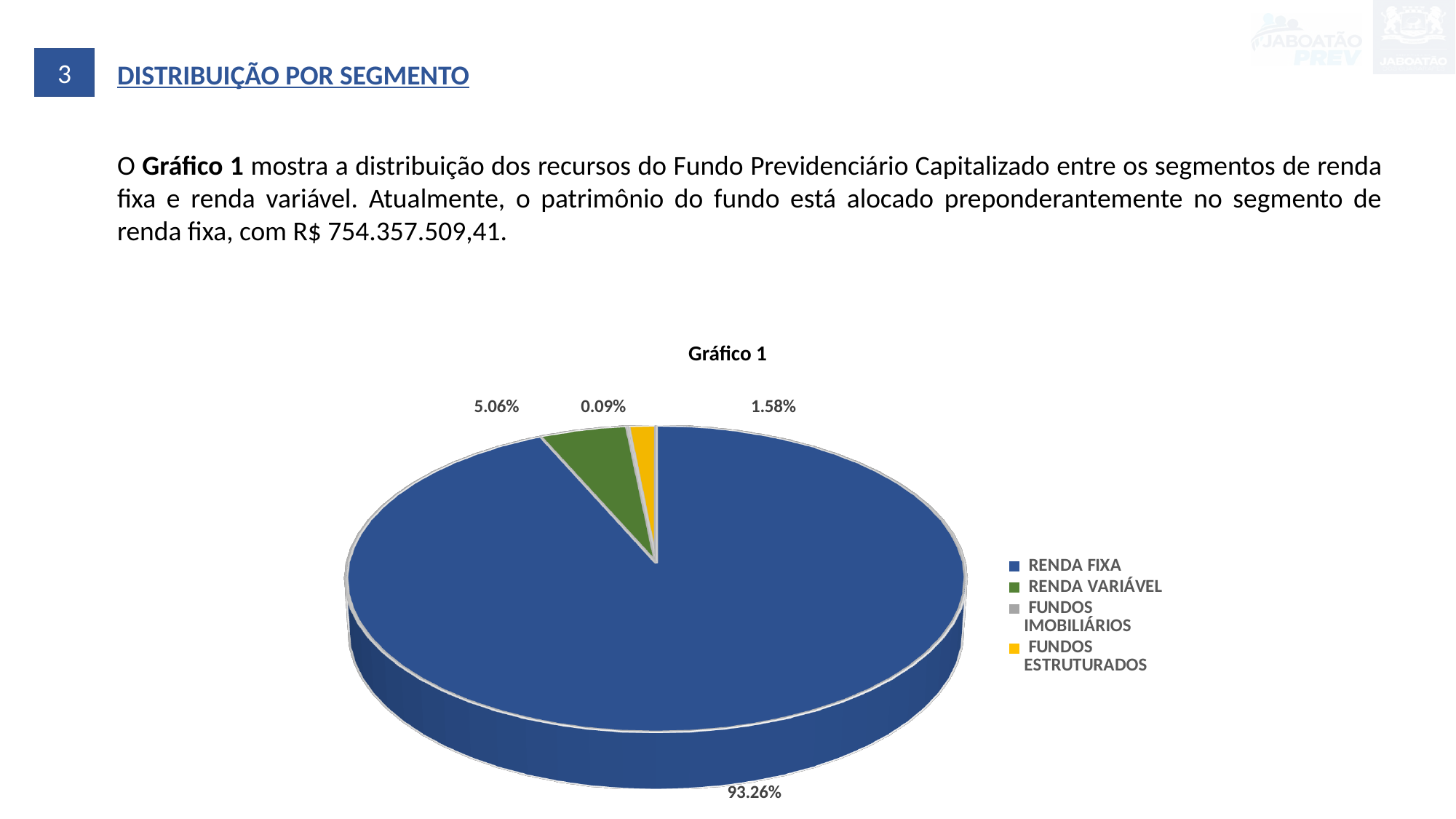
What colour represents FUNDOS ESTRUTURADOS in Gráfico 1? yellow What is the difference in percentage points between RENDA VARIÁVEL and FUNDOS ESTRUTURADOS in Gráfico 1? 3.48% How many segments (slices) does Gráfico 1 show? 4 What share of the pie in Gráfico 1 is FUNDOS IMOBILIÁRIOS? 0.09% Which segment has the smallest slice in Gráfico 1? FUNDOS IMOBILIÁRIOS Which segment has the largest slice in Gráfico 1? RENDA FIXA What share of the pie in Gráfico 1 is RENDA VARIÁVEL? 5.06% What share of the pie in Gráfico 1 is FUNDOS ESTRUTURADOS? 1.58% What type of chart is Gráfico 1? pie chart How many entries does the legend of Gráfico 1 list? 4 In Gráfico 1, which is larger: RENDA VARIÁVEL or FUNDOS ESTRUTURADOS? RENDA VARIÁVEL